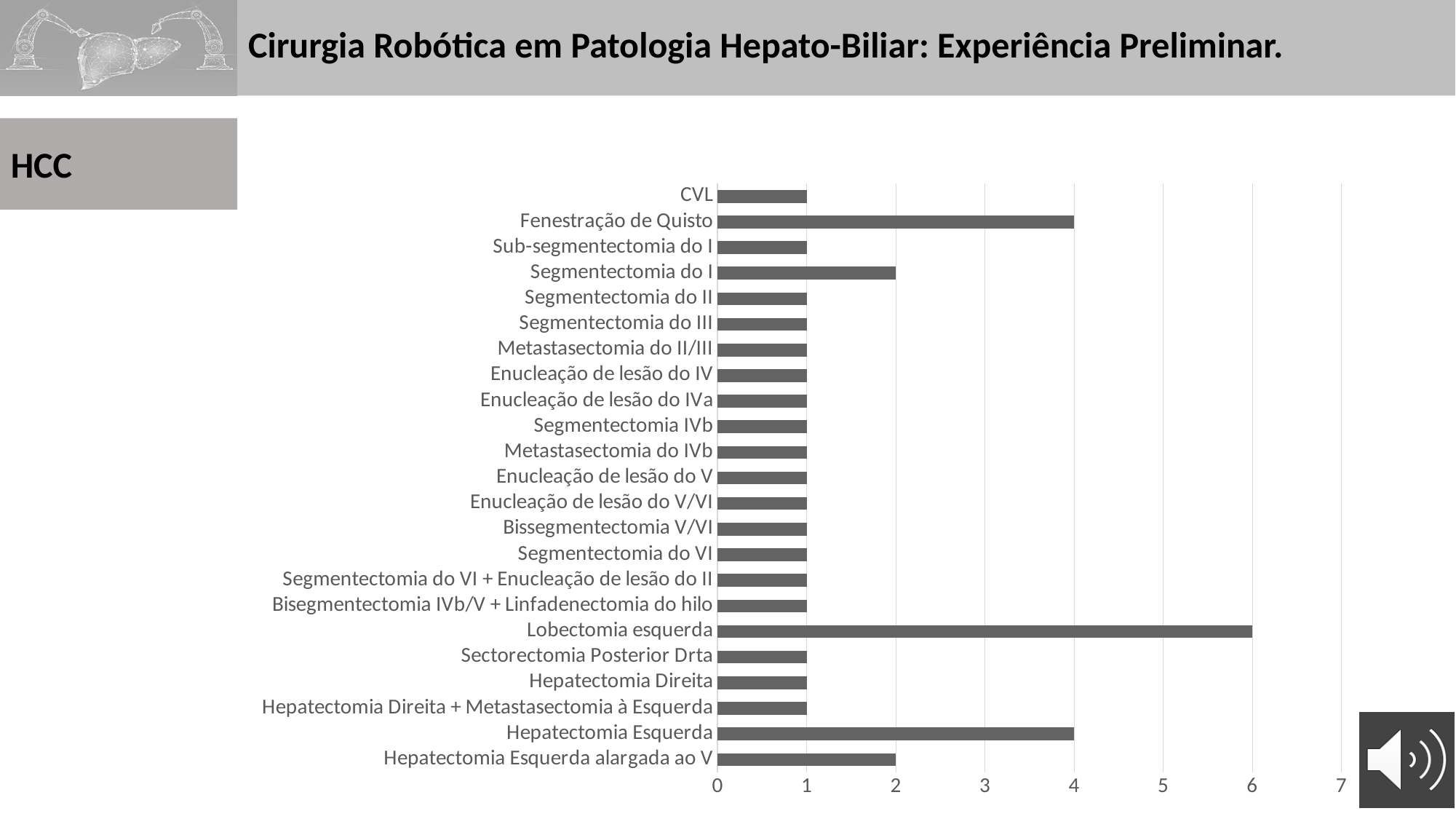
What is the value for Segmentectomia do I? 2 Is the value for Lobectomia esquerda greater or less than 5? greater What is the value for Lobectomia esquerda? 6 What is the difference between the values for Lobectomia esquerda and Hepatectomia Esquerda? 2 Which is larger, the value for Fenestração de Quisto or the value for Segmentectomia do I? Fenestração de Quisto How many categories are shown on the chart? 23 What is the value for Hepatectomia Esquerda alargada ao V? 2 What is the value for CVL? 1 Which category has the highest value? Lobectomia esquerda What is the value for Fenestração de Quisto? 4 What is the maximum value shown on the horizontal axis? 7 What kind of chart is shown on the slide? bar chart